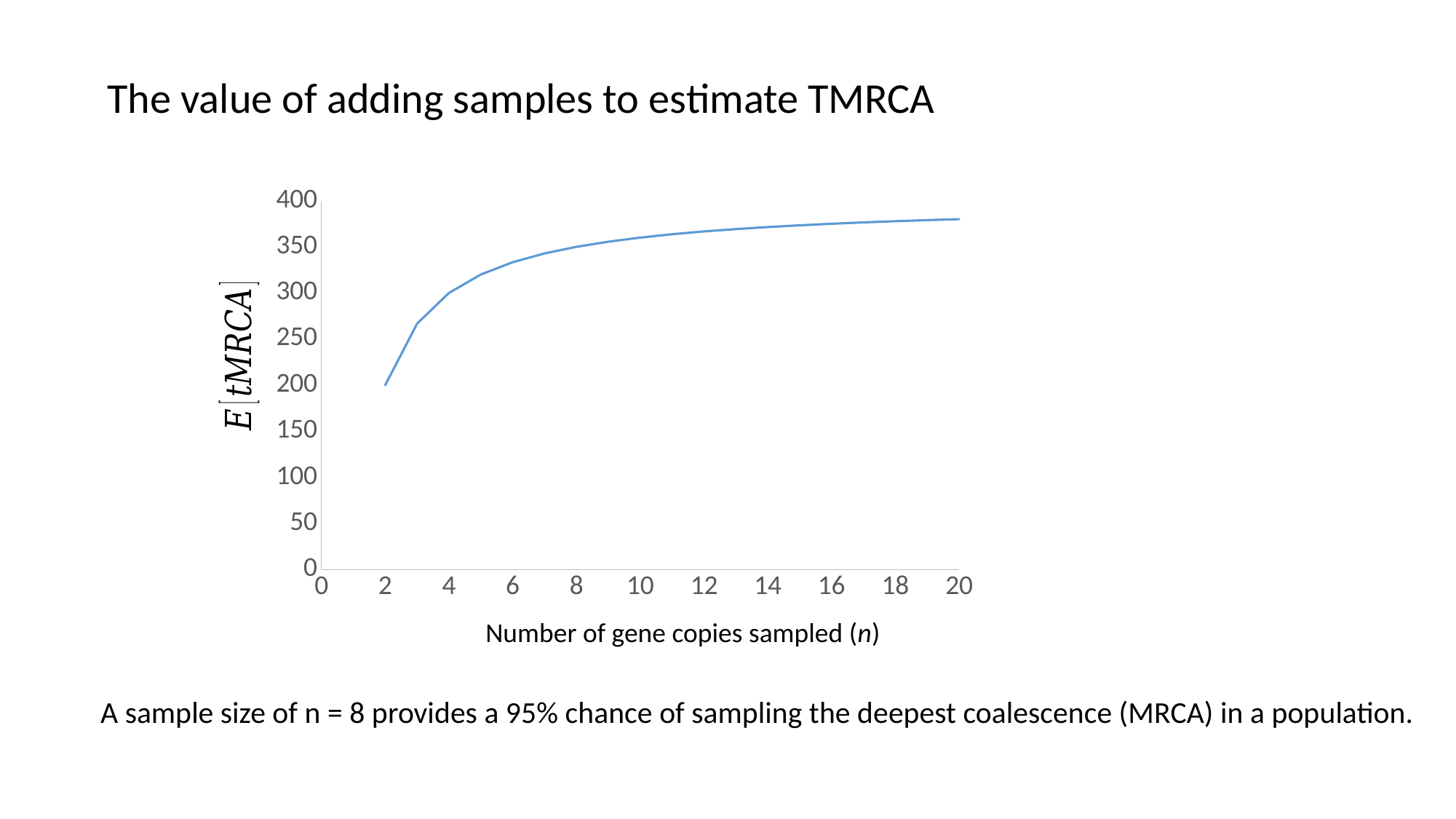
Is the value of E[tMRCA] at n = 6 greater or less than 350? less Is the value of E[tMRCA] at n = 2 greater or less than 250? less What is the title of the slide containing the chart? The value of adding samples to estimate TMRCA Is the value of E[tMRCA] at n = 20 greater or less than 400? less At which number of gene copies sampled is E[tMRCA] lowest? 2 Which is larger, E[tMRCA] at n = 4 or at n = 12? n = 12 Does E[tMRCA] rise or fall as the number of gene copies sampled increases? rise What kind of chart is shown on the slide? line chart At which number of gene copies sampled is E[tMRCA] highest? 20 What is the label of the x axis? Number of gene copies sampled (n)